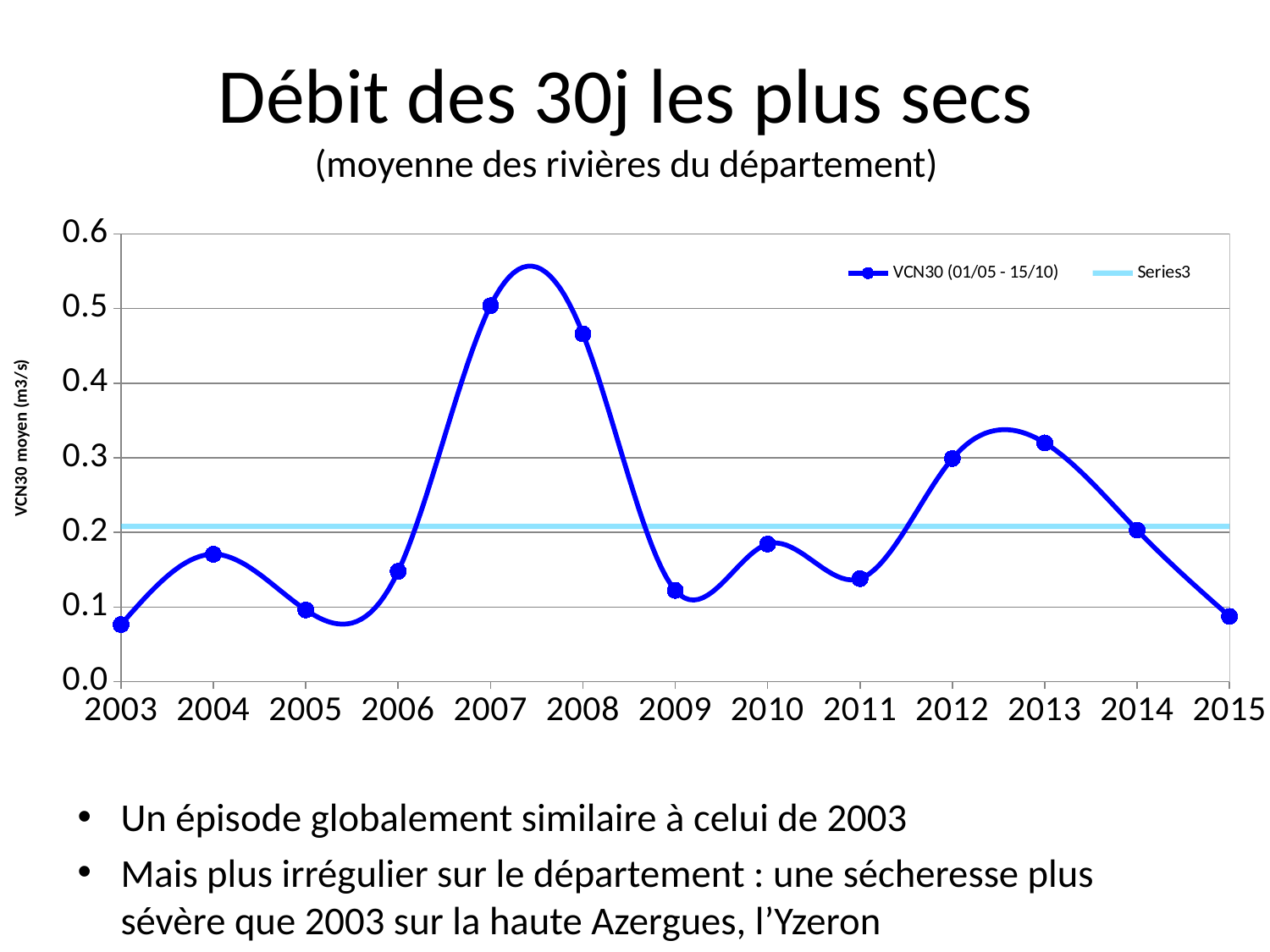
Is the VCN30 value for 2007 greater or less than 0.4? greater Is the VCN30 value for 2013 greater or less than 0.3? greater What is the label on the y axis? VCN30 moyen (m3/s) What kind of chart is shown on the slide? line chart Which year has the highest VCN30 value? 2007 Which year has the larger VCN30 value, 2004 or 2005? 2004 Do the VCN30 values rise or fall from 2013 to 2015? fall Which year has the larger VCN30 value, 2007 or 2008? 2007 Is the VCN30 value for 2004 greater or less than 0.2? less How many series does the legend list? 2 How many years are plotted on the x axis? 13